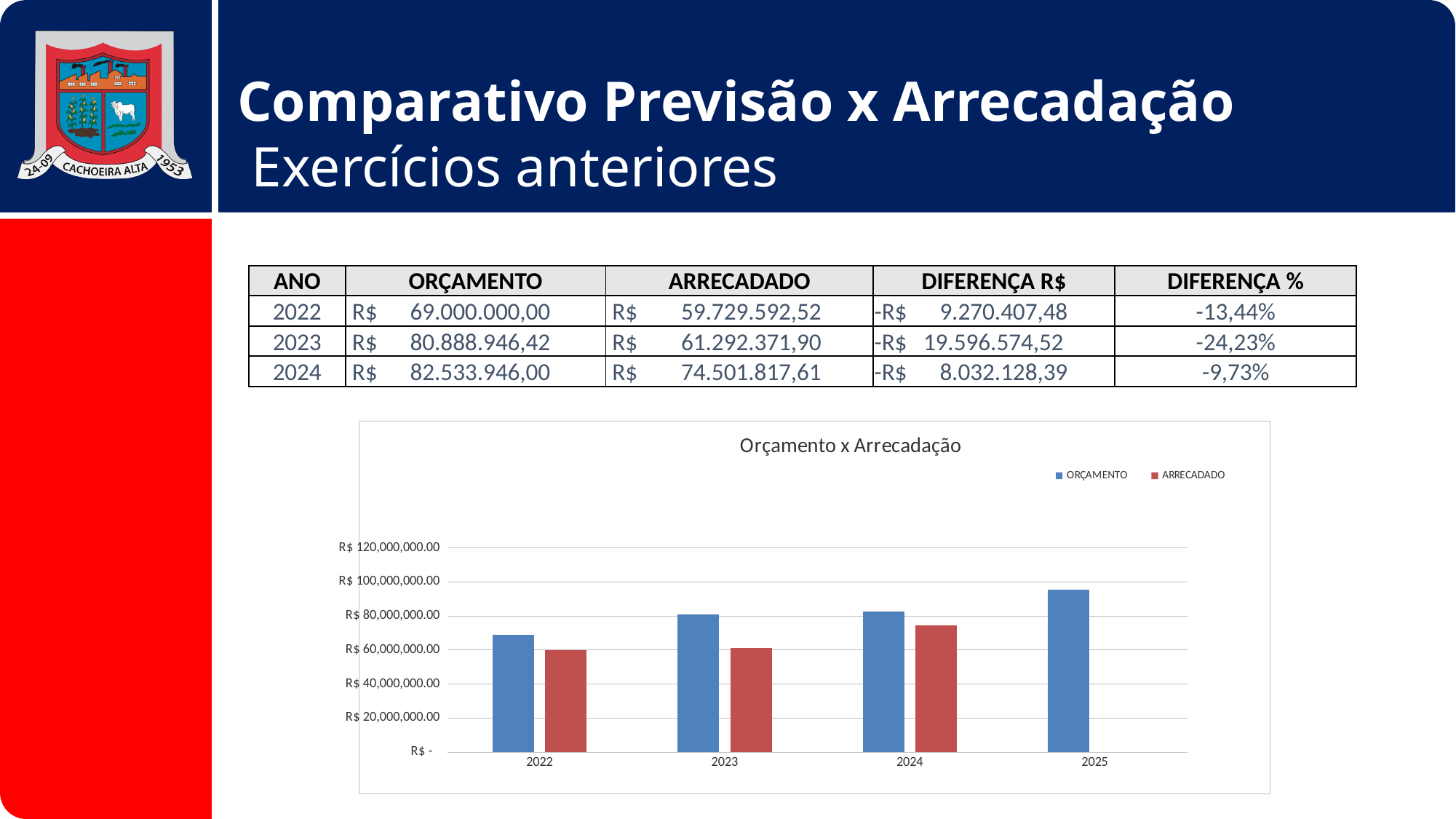
How many years are shown on the x axis of the chart? 4 In 2024, which is larger, ORÇAMENTO or ARRECADADO? ORÇAMENTO Which year has the highest ARRECADADO bar in the chart? 2024 What is the title of the chart? Orçamento x Arrecadação Which year in the chart has only an ORÇAMENTO bar and no ARRECADADO bar? 2025 Is the ORÇAMENTO value for 2025 greater or less than R$ 80,000,000.00? greater Is the ARRECADADO value for 2024 greater or less than R$ 80,000,000.00? less Which year has the highest ORÇAMENTO bar in the chart? 2025 What kind of chart is shown on the slide? bar chart Do the ORÇAMENTO bars rise or fall from 2022 to 2025? rise How many series does the chart legend list? 2 Is the ORÇAMENTO value for 2025 greater or less than R$ 100,000,000.00? less